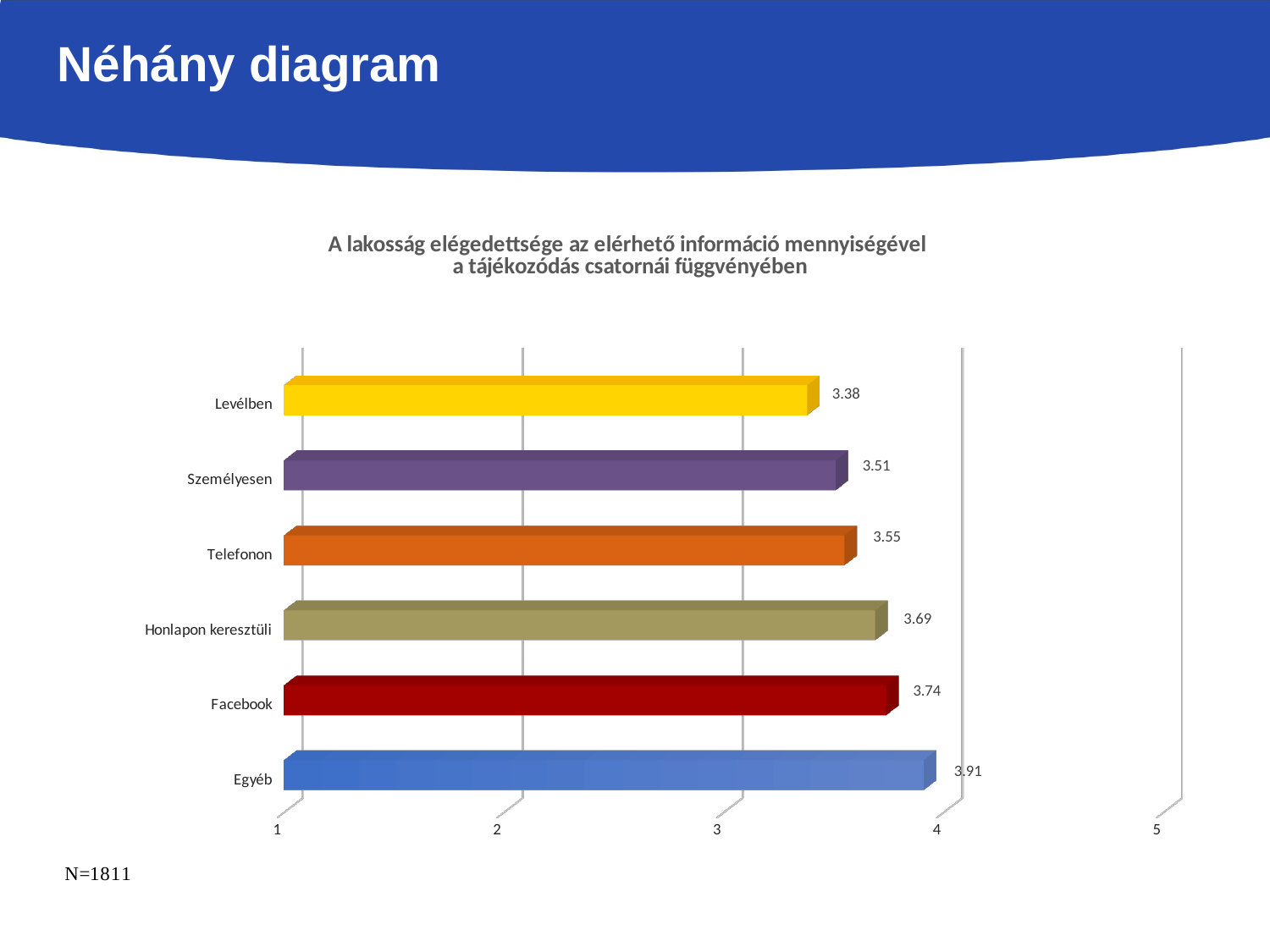
Which is larger, the value for Telefonon or the value for Személyesen? Telefonon What is the value for Facebook? 3.74 Is the value for Facebook greater or less than 4? less What sample size (N) is noted on the slide? N=1811 What kind of chart is shown on the slide? bar chart What is the value for Levélben? 3.38 What is the difference between the values for Egyéb and Levélben? 0.53 Which category has the highest value? Egyéb Which category has the lowest value? Levélben What is the value for Telefonon? 3.55 What is the value for Honlapon keresztüli? 3.69 How many categories are shown in the chart? 6